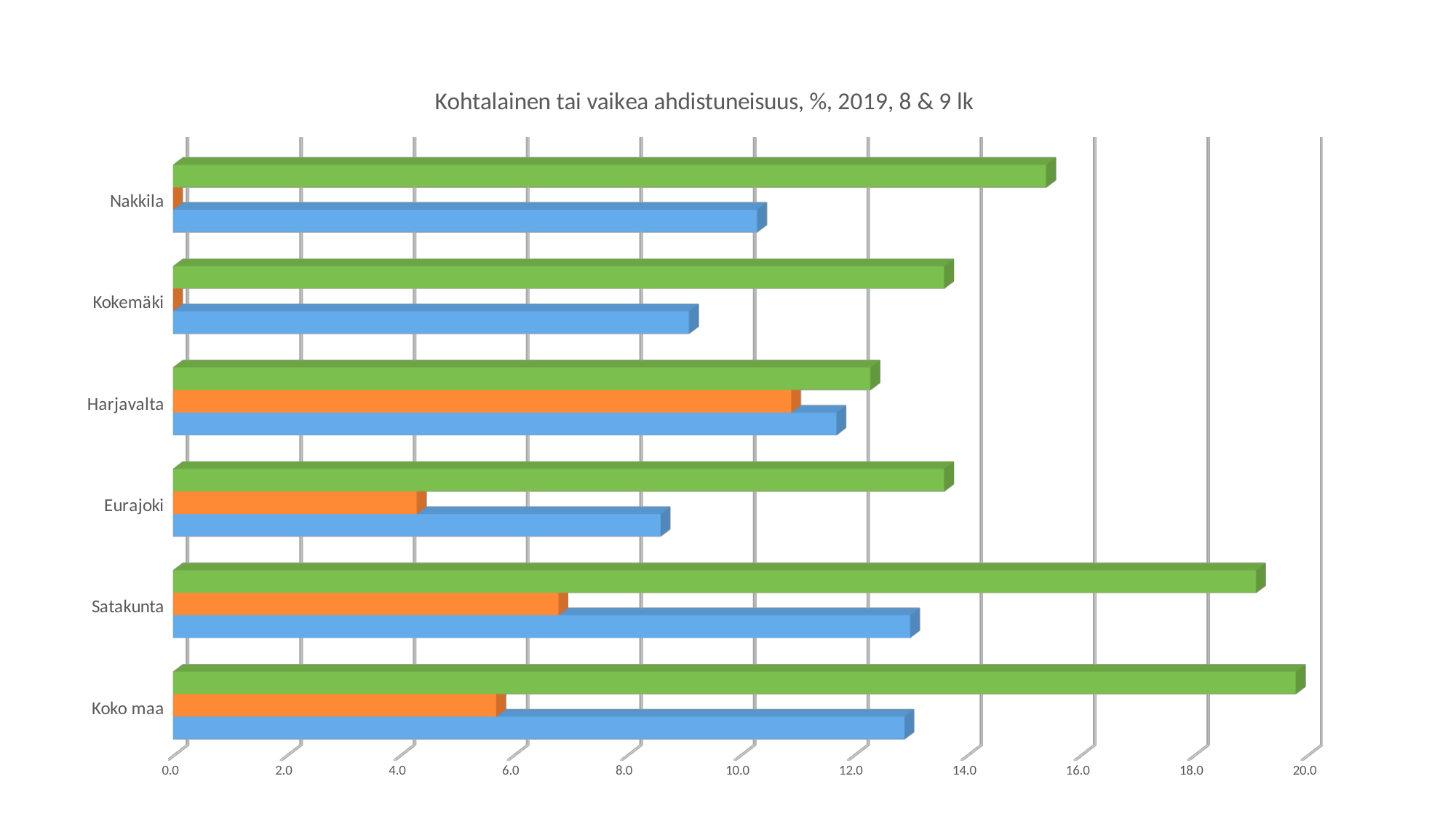
Is the green bar for Satakunta greater or less than 18.0? greater Which is larger, the green bar for Nakkila or the green bar for Kokemäki? Nakkila Which is larger, the blue bar for Harjavalta or the blue bar for Eurajoki? Harjavalta Which category has the longest green bar? Koko maa Is the blue bar for Kokemäki greater or less than 10.0? less Which category has the longest orange bar? Harjavalta How many bars are plotted for each category in the chart? 3 Which category has the shortest green bar? Harjavalta Is the orange bar for Eurajoki greater or less than 6.0? less What kind of chart is shown on the slide? bar chart What is the title of the chart? Kohtalainen tai vaikea ahdistuneisuus, %, 2019, 8 & 9 lk How many categories are shown on the vertical axis of the chart? 6